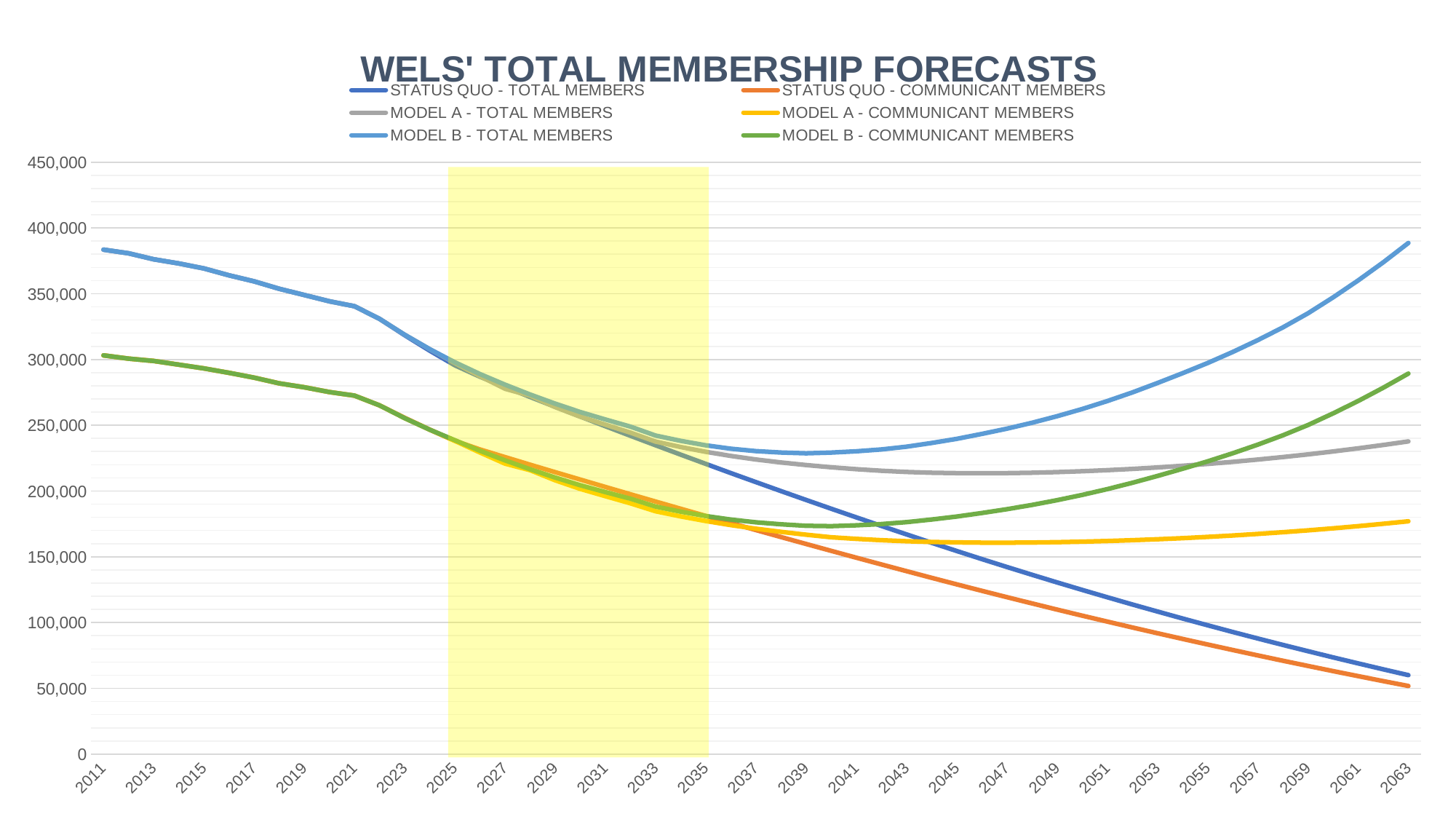
What is the title of the chart? WELS' TOTAL MEMBERSHIP FORECASTS How many series does the legend list? 6 Which series has the highest value in 2063? MODEL B - TOTAL MEMBERS Does the STATUS QUO - TOTAL MEMBERS line rise or fall from 2011 to 2063? fall Which series is drawn in orange? STATUS QUO - COMMUNICANT MEMBERS Is the value for MODEL A - COMMUNICANT MEMBERS in 2063 greater or less than 200,000? less Is the value for STATUS QUO - TOTAL MEMBERS in 2063 greater or less than 100,000? less What kind of chart is shown on the slide? line chart Is the value for MODEL B - TOTAL MEMBERS in 2011 greater or less than 350,000? greater In 2063, which is larger: MODEL B - TOTAL MEMBERS or MODEL A - TOTAL MEMBERS? MODEL B - TOTAL MEMBERS Which series has the lowest value in 2063? STATUS QUO - COMMUNICANT MEMBERS